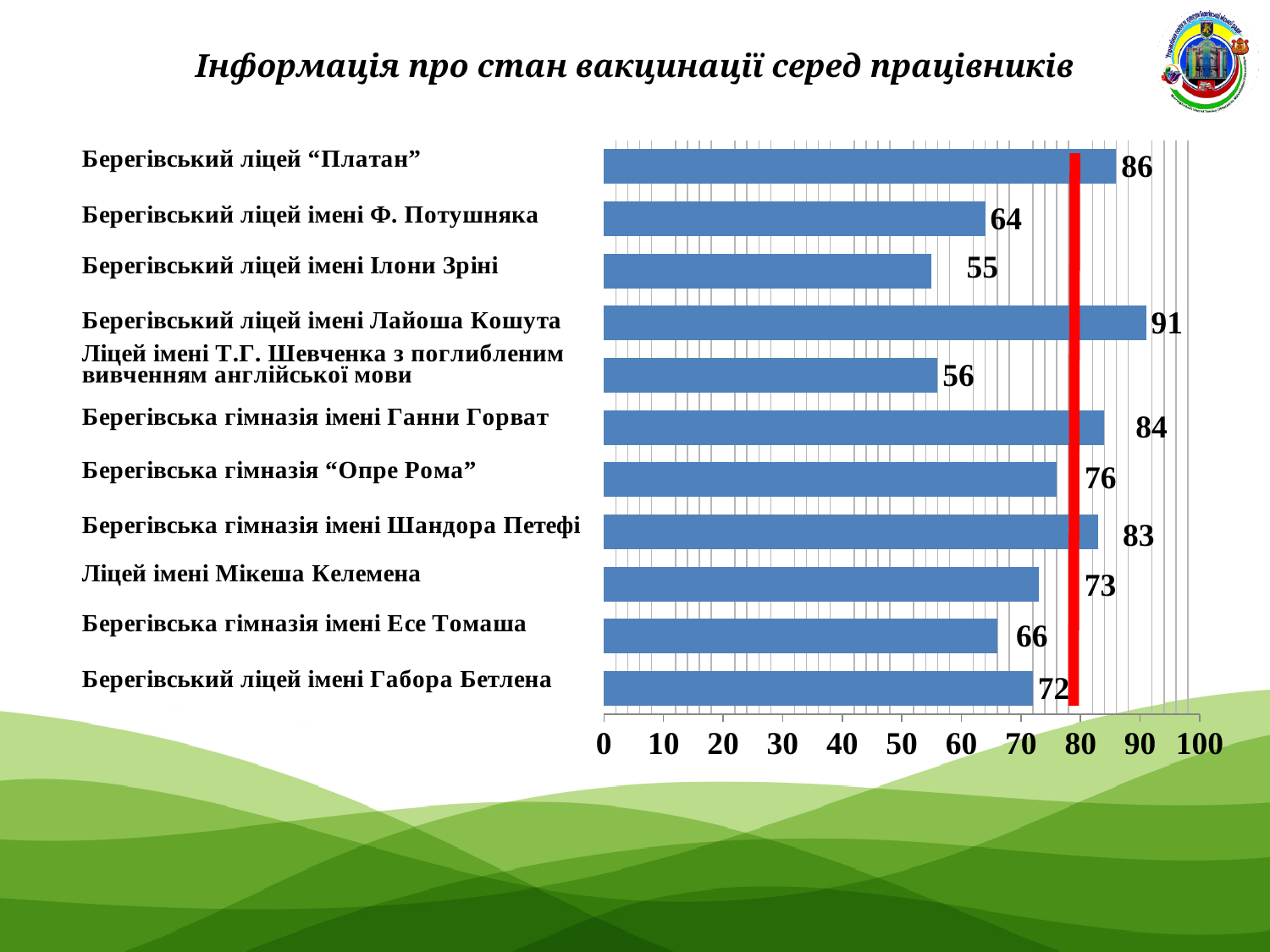
Which is larger: the value for Берегівська гімназія “Опре Рома” or the value for Берегівська гімназія імені Есе Томаша? Берегівська гімназія “Опре Рома” Is the value for Берегівський ліцей імені Габора Бетлена greater or less than 80? less How many categories are shown in the chart? 11 What is the difference between the values for Берегівський ліцей імені Лайоша Кошута and Берегівський ліцей імені Ілони Зріні? 36 Which category has the lowest value? Берегівський ліцей імені Ілони Зріні What is the title of the slide? Інформація про стан вакцинації серед працівників What value is shown for Берегівський ліцей “Платан”? 86 What kind of chart is shown on the slide? bar chart Which category has the highest value? Берегівський ліцей імені Лайоша Кошута What value is shown for Берегівська гімназія імені Ганни Горват? 84 What value is shown for Ліцей імені Мікеша Келемена? 73 What is the difference between the values for Берегівський ліцей “Платан” and Берегівський ліцей імені Ф. Потушняка? 22